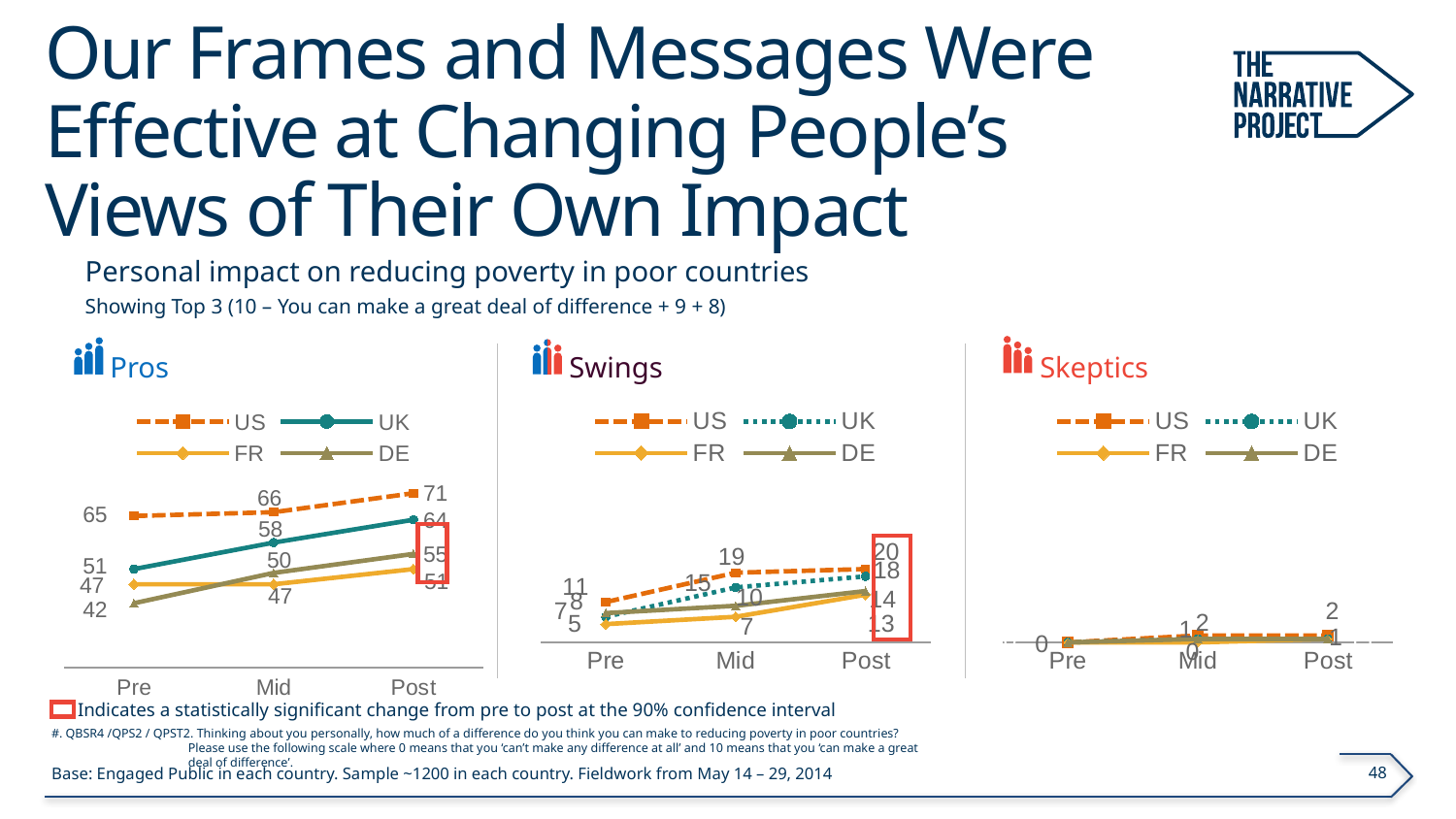
In the Pros chart, which country has the highest value at Post? US In the Pros chart, what is the value for US at Pre? 65 In the Pros chart, what is the value for DE at Pre? 42 How many series does the legend of the Swings chart list? 4 In the Pros chart, what is the value for US at Post? 71 In the Swings chart, what is the value for UK at Post? 18 In the Pros chart, which is larger at Post: UK or FR? UK In the Pros chart, which country has the lowest value at Pre? DE What type of chart is used for the Pros, Swings and Skeptics panels? Line chart In the Pros chart, by how much did the US value increase from Pre to Post? 6 In the Pros chart, what is the value for UK at Post? 64 In the Swings chart, what is the value for US at Mid? 19